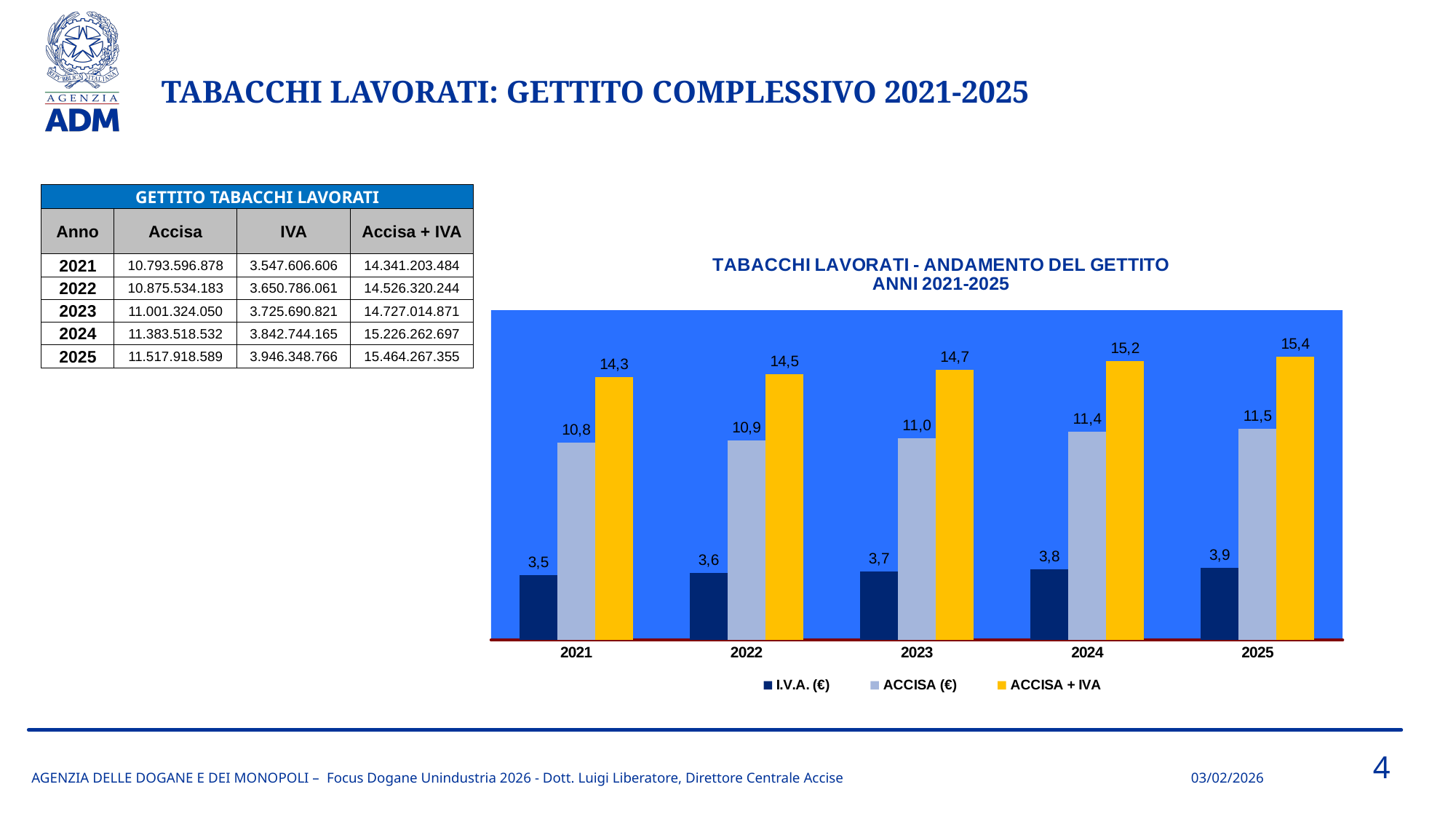
What is the value of the I.V.A. (€) bar for 2021? 3,5 What is the difference between the ACCISA (€) values for 2025 and 2021? 0,7 What is the value of the ACCISA (€) bar for 2023? 11,0 In which year is the ACCISA + IVA value highest? 2025 How many series does the chart legend list? 3 In which year is the I.V.A. (€) value lowest? 2021 What is the difference between the ACCISA + IVA values for 2025 and 2021? 1,1 Do the ACCISA + IVA values rise or fall from 2021 to 2025? Rise How many years are shown on the x axis of the chart? 5 What kind of chart is shown on the slide? Bar chart What is the value of the ACCISA + IVA bar for 2025? 15,4 Which is larger: the ACCISA (€) value for 2024 or the ACCISA (€) value for 2022? 2024